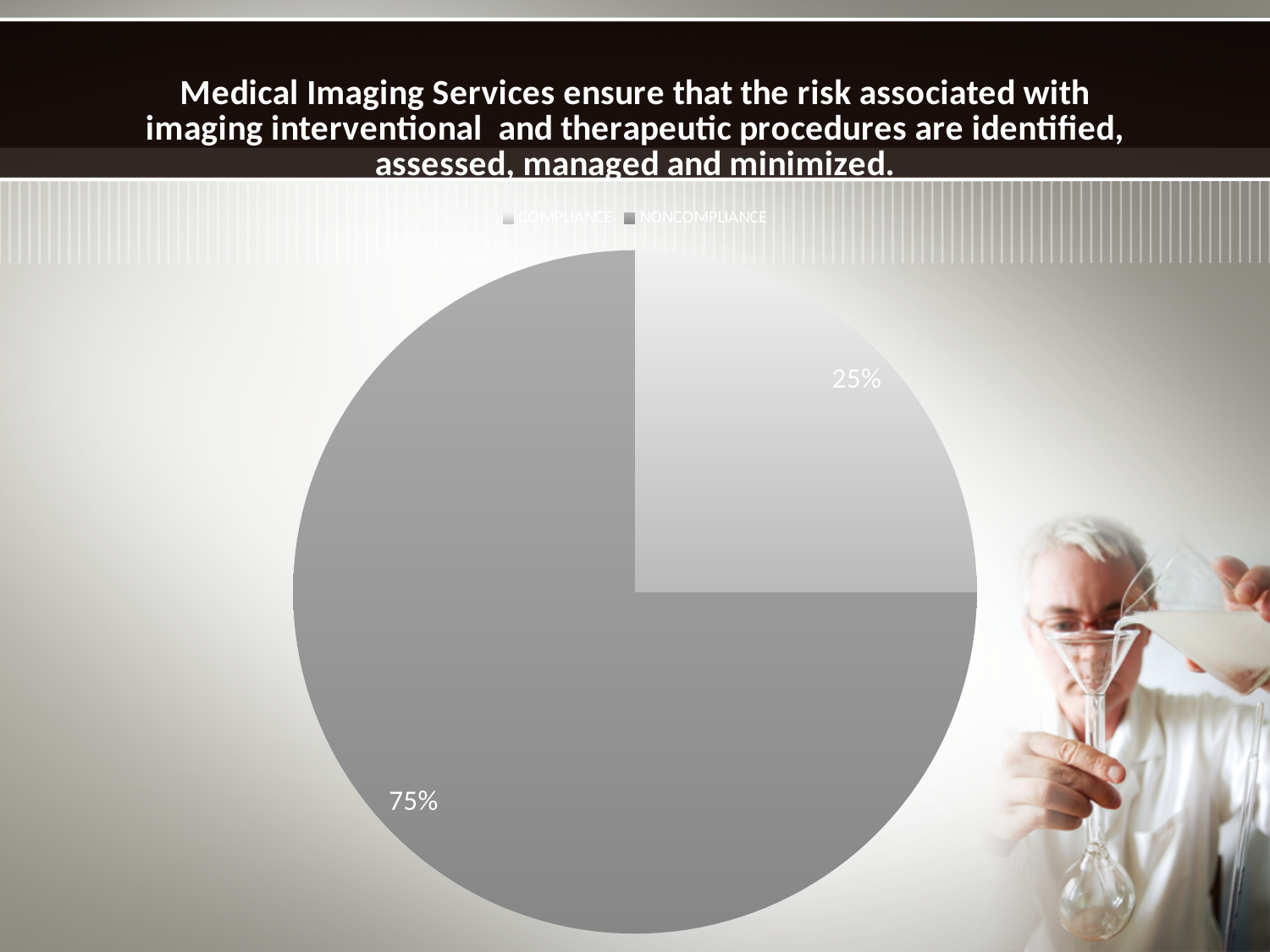
What is the difference in percentage points between the NONCOMPLIANCE and COMPLIANCE slices? 50 Is the COMPLIANCE slice shown in a lighter or darker shade than the NONCOMPLIANCE slice? lighter Which legend entry is listed first? COMPLIANCE How many entries does the legend list? 2 What kind of chart is shown on the slide? pie chart What share of the pie does the NONCOMPLIANCE slice take? 75% What percentage of the pie is labelled NONCOMPLIANCE? 75% Which slice of the pie is the largest? NONCOMPLIANCE Which slice of the pie is the smallest? COMPLIANCE What percentage of the pie is labelled COMPLIANCE? 25% Which is larger, the COMPLIANCE slice or the NONCOMPLIANCE slice? NONCOMPLIANCE How many slices does the pie chart have? 2